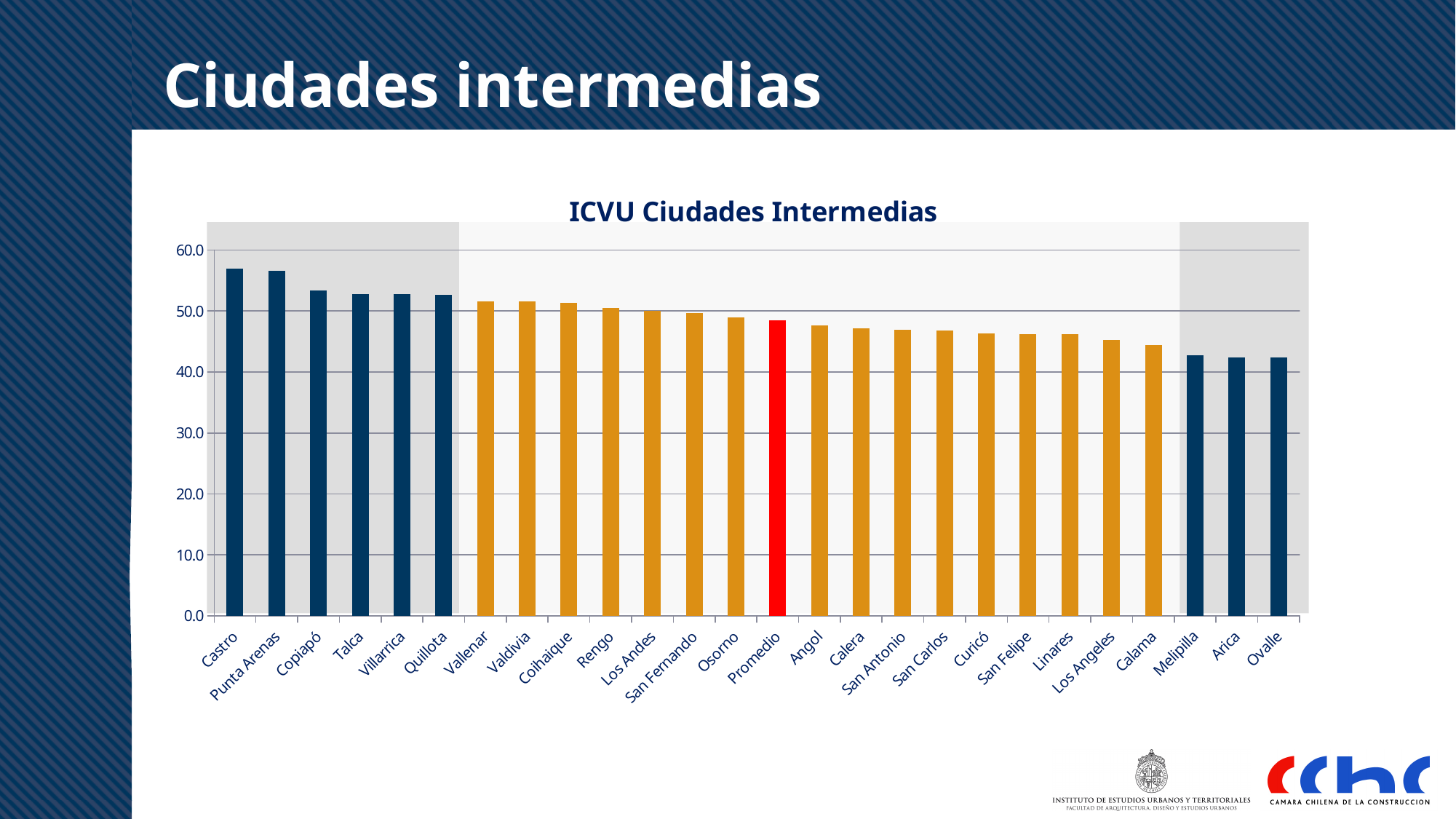
How many categories (bars) are plotted in the chart? 26 Is the value for Promedio greater or less than 50.0? less Which category is shown with a red bar? Promedio Do the values rise or fall moving from left to right along the x axis? fall Is the value for Castro greater or less than 50.0? greater What kind of chart is shown on the slide? bar chart Is the value for Melipilla greater or less than 40.0? greater Which has a higher value, Vallenar or Melipilla? Vallenar What is the title of the chart? ICVU Ciudades Intermedias Which has a higher value, Castro or Ovalle? Castro